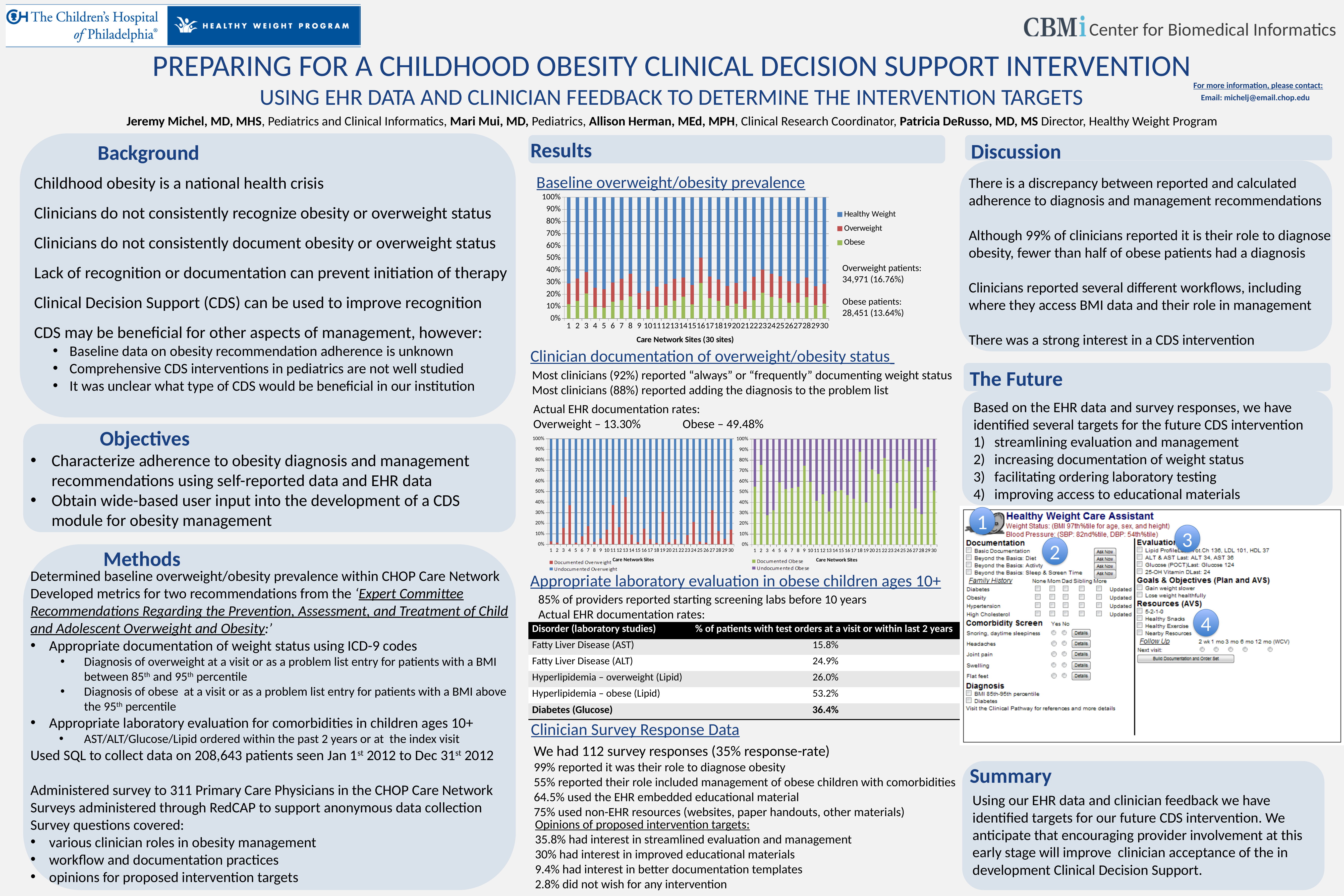
In the Documented Overweight chart (left chart under 'Clinician documentation of overweight/obesity status'), is the Documented Overweight value for site 1 greater or less than 20%? less How many Care Network sites are plotted on the x axis of the 'Baseline overweight/obesity prevalence' chart? 30 In the 'Baseline overweight/obesity prevalence' chart, what number of obese patients is printed beside the legend? 28,451 (13.64%) In the 'Baseline overweight/obesity prevalence' chart, what number of overweight patients is printed beside the legend? 34,971 (16.76%) In the 'Baseline overweight/obesity prevalence' chart, what are the three legend entries? Healthy Weight, Overweight, Obese In the 'Baseline overweight/obesity prevalence' chart, is the Healthy Weight value for site 1 greater or less than 60%? greater In the Documented Obese chart (right chart under 'Clinician documentation of overweight/obesity status'), is the Documented Obese value for site 2 greater or less than 60%? greater How many series does the legend of the Documented Overweight chart (left chart under 'Clinician documentation of overweight/obesity status') list? 2 In the 'Baseline overweight/obesity prevalence' chart, which colour represents the Obese series? green How many series does the legend of the 'Baseline overweight/obesity prevalence' chart list? 3 What kind of chart is the 'Baseline overweight/obesity prevalence' chart? bar chart